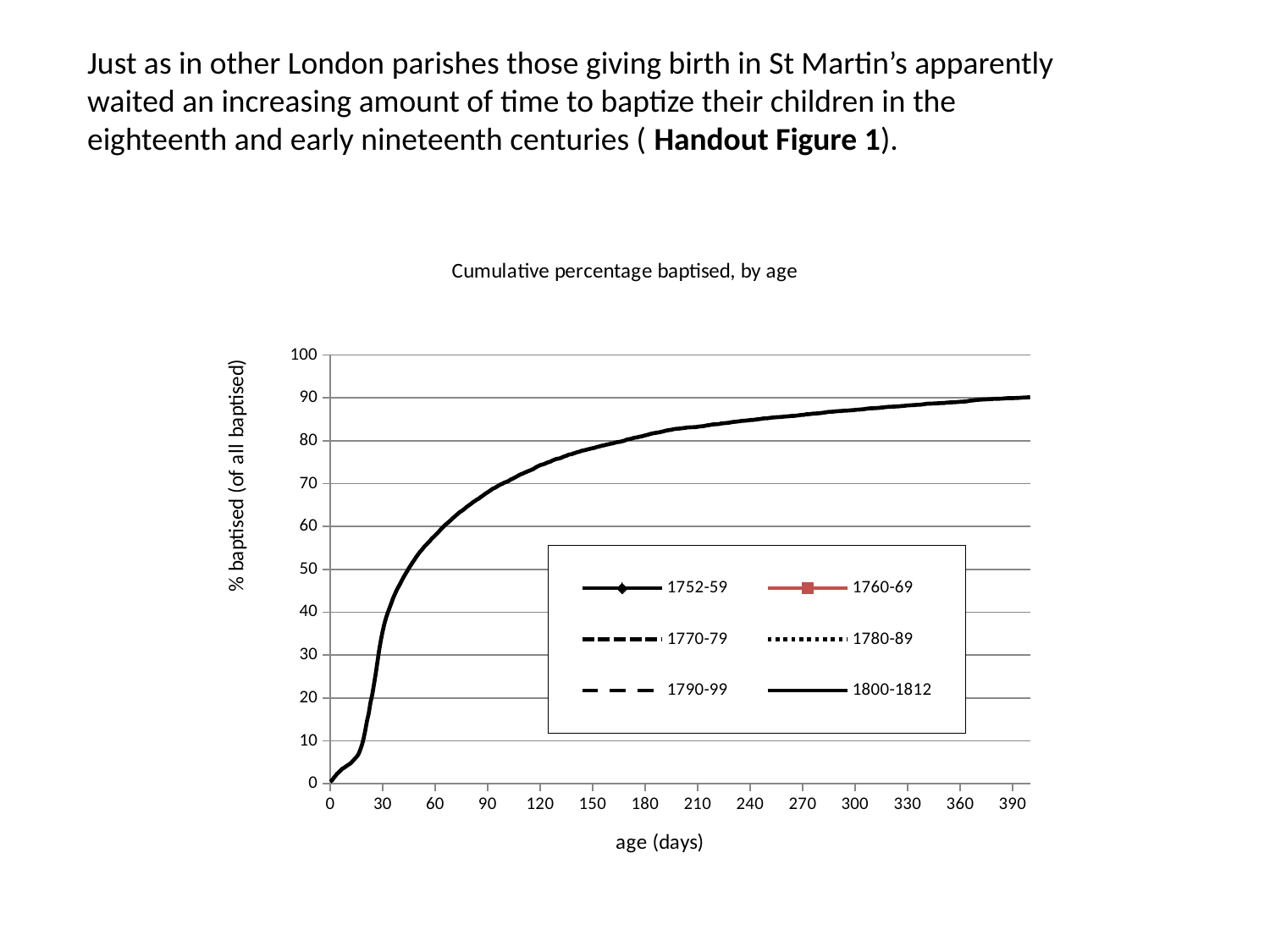
Do the plotted values rise or fall as age in days increases? rise Is the value of the plotted line at 120 days greater or less than 70? greater Is the value of the plotted line at 90 days greater or less than 60? greater Is the value of the plotted line at 300 days greater or less than 90? less What is the title of the chart? Cumulative percentage baptised, by age How many series does the chart's legend list? 6 What kind of chart is shown on the slide? line chart What is the label of the x axis? age (days)